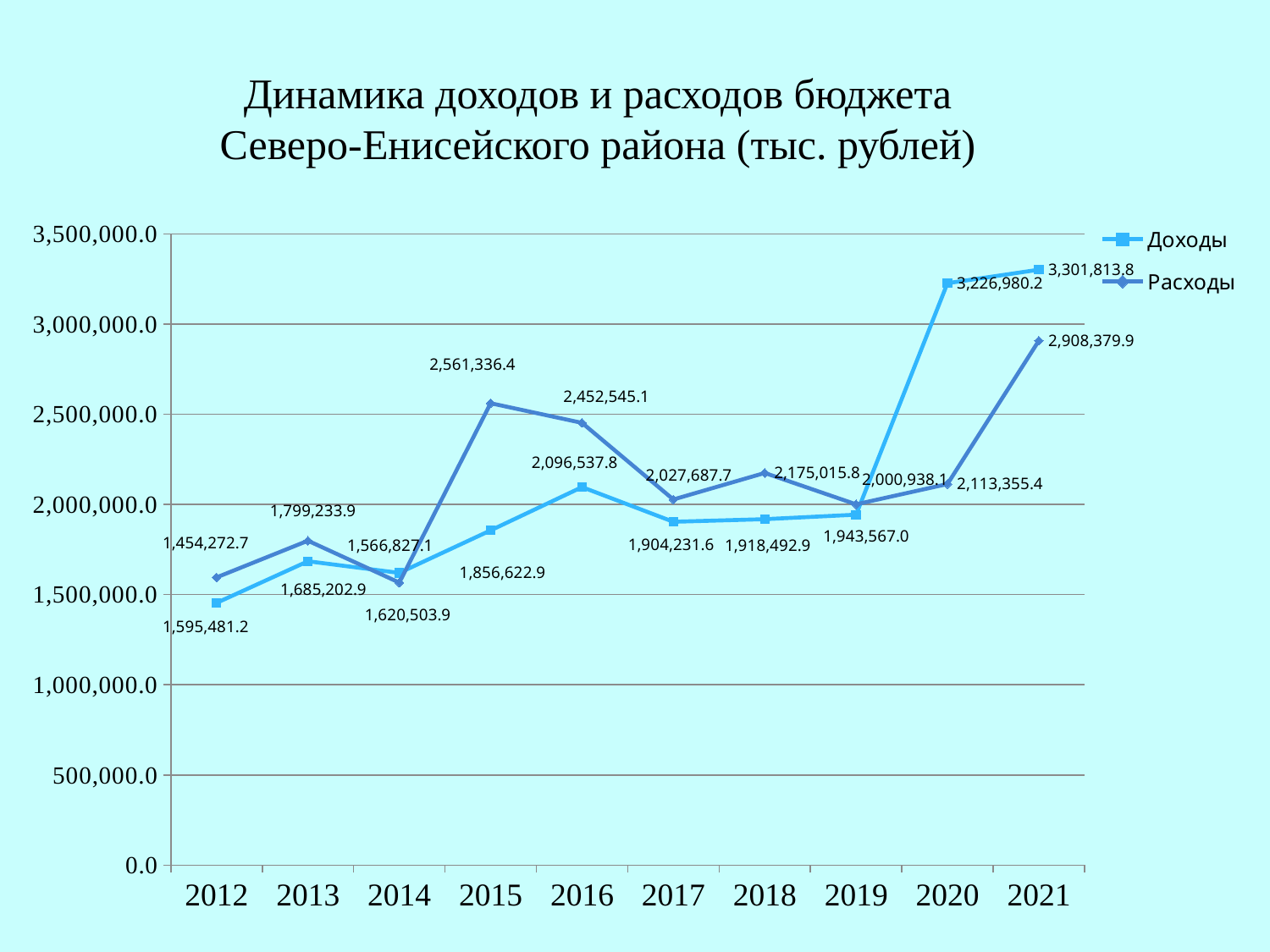
What is the value of Доходы in 2020? 3,226,980.2 What is the value of Доходы in 2021? 3,301,813.8 How many years are shown on the x axis? 10 Which is larger in 2016, Доходы or Расходы? Расходы What is the value of Расходы in 2015? 2,561,336.4 What kind of chart is this? line chart How many series does the legend list? 2 In which year is Расходы lowest? 2014 Does Доходы rise or fall from 2019 to 2021? rise What is the difference between Доходы and Расходы in 2020? 1,113,624.8 What is the value of Расходы in 2018? 2,175,015.8 In which year is Доходы highest? 2021